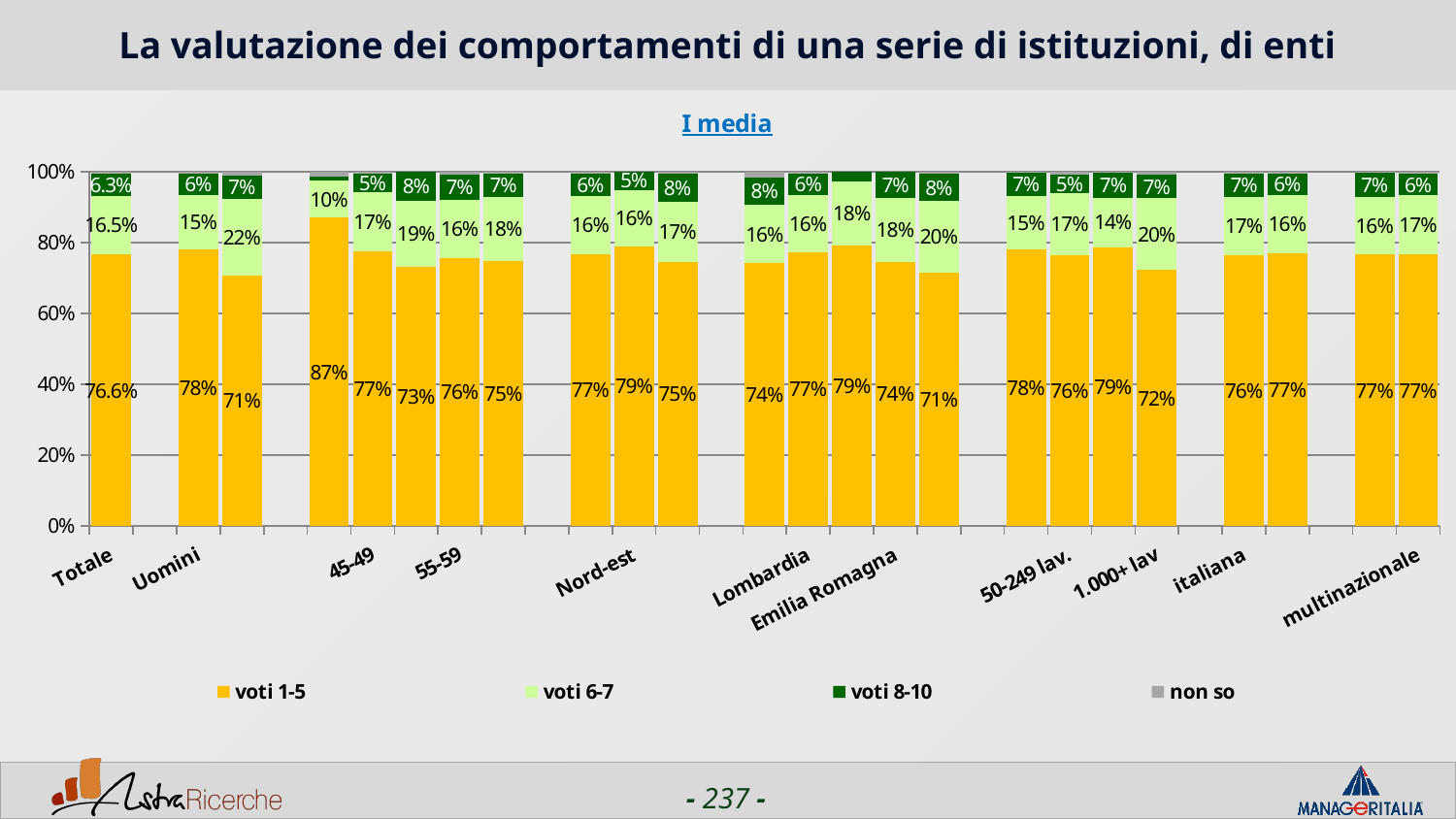
What is the 'voti 8-10' value for 55-59? 7% What is the 'voti 1-5' value for Uomini? 78% What is the title of the chart? I media Which has a larger 'voti 1-5' value, Uomini or 1.000+ lav? Uomini What is the 'voti 1-5' value for Nord-est? 79% What is the value of the 'voti 6-7' segment for Totale? 16.5% What kind of chart is shown on the slide? Stacked bar chart What is the value of the 'voti 8-10' segment for Totale? 6.3% What is the value of the 'voti 1-5' segment for Totale? 76.6% What is the 'voti 6-7' value for 1.000+ lav? 20% How many series does the legend list? 4 What is the difference in 'voti 1-5' between Uomini and 1.000+ lav? 6 percentage points